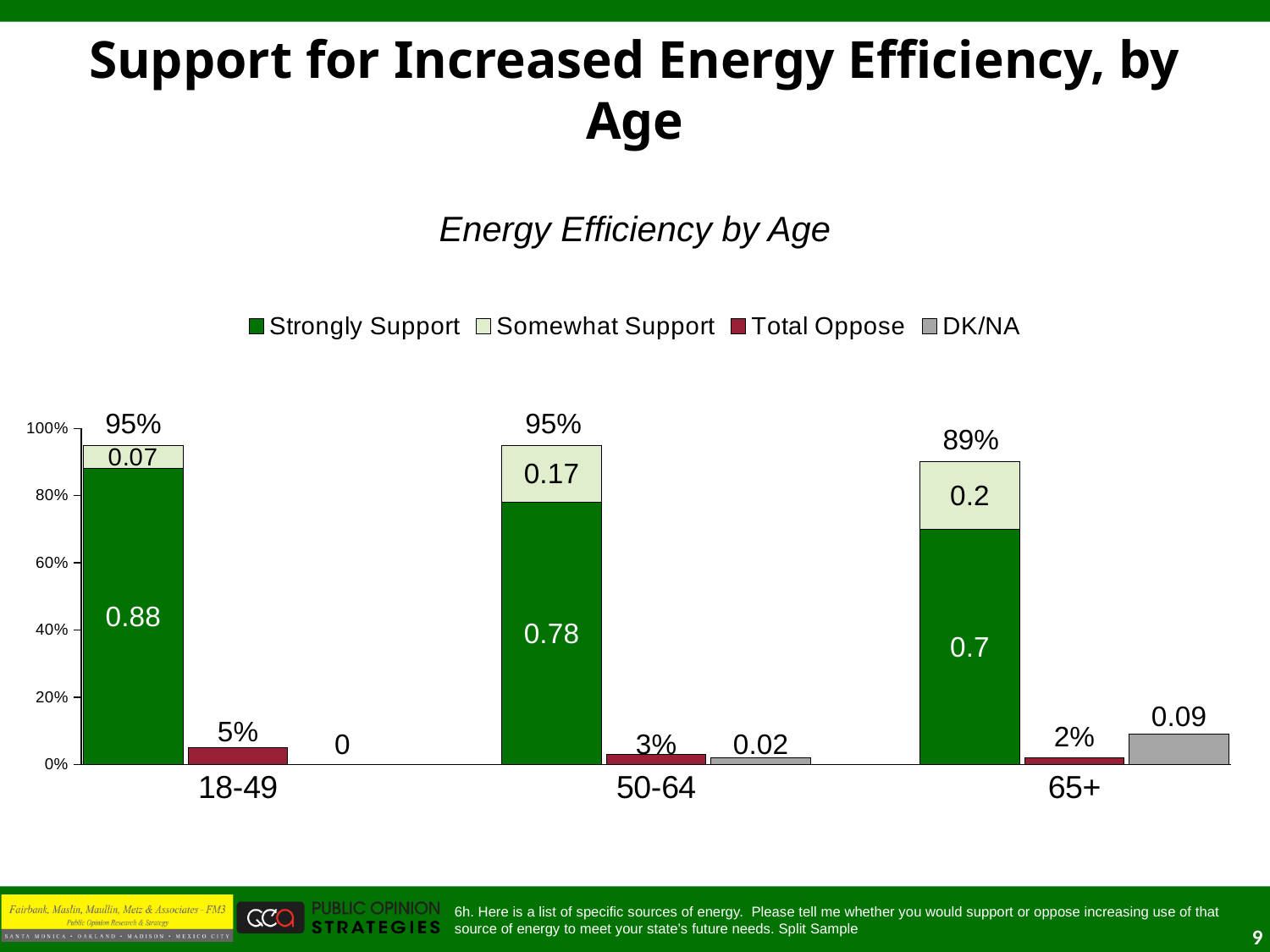
What is the total support shown above the stacked bar for the 50-64 age group? 95% How many age groups are shown on the x axis? 3 What is the Strongly Support value for the 18-49 age group? 0.88 How many series does the legend list? 4 What is the difference between the Strongly Support values for 18-49 and 65+? 0.18 What is the DK/NA value for the 65+ age group? 0.09 Which age group has the highest Strongly Support value? 18-49 What kind of chart is shown on the slide? Stacked bar chart Is the Somewhat Support value larger for 50-64 or for 18-49? 50-64 What is the Total Oppose value for the 50-64 age group? 3% What is the Somewhat Support value for the 65+ age group? 0.2 Which age group has the lowest total support (stacked bar total)? 65+